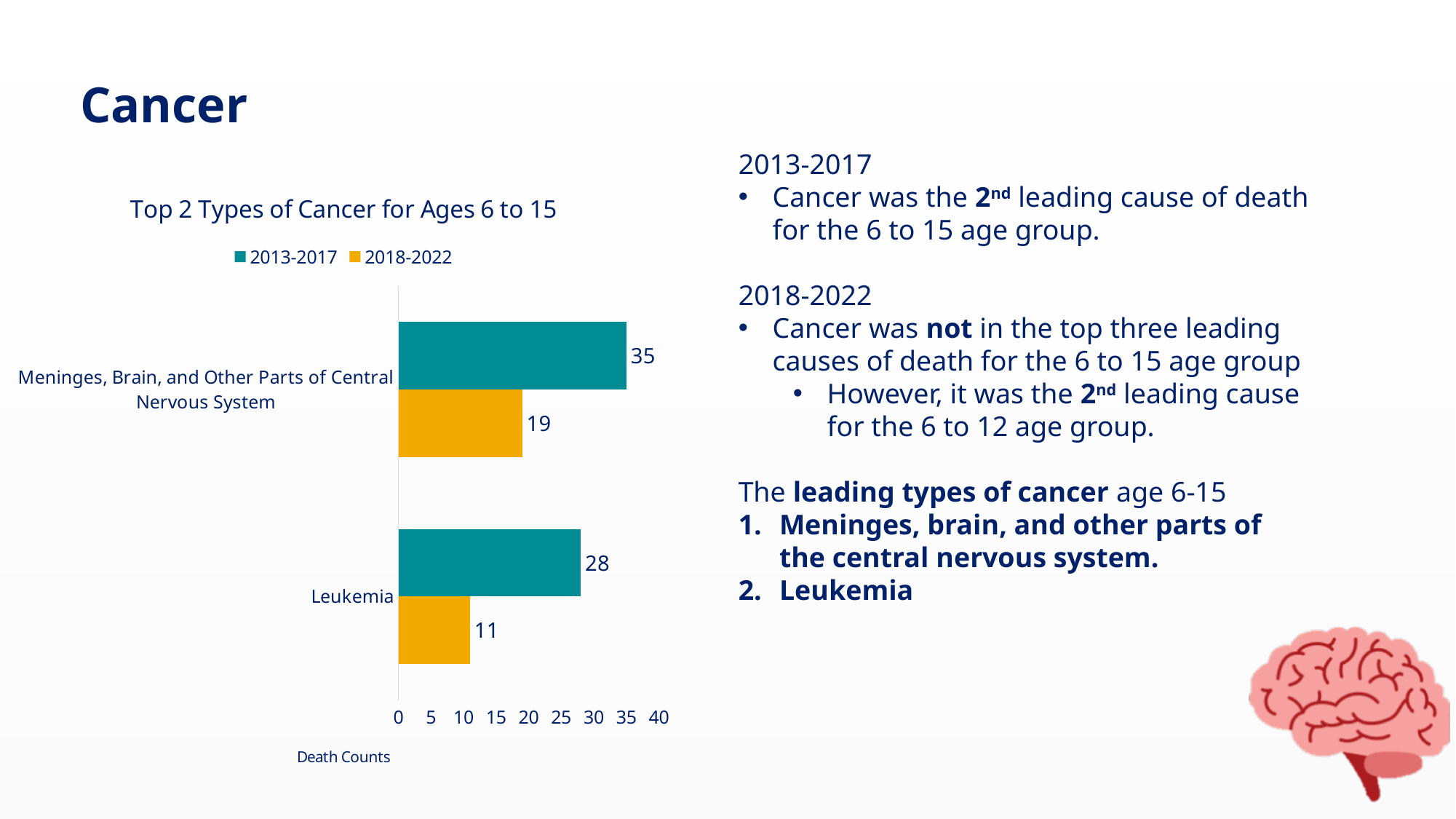
What is the death count for Leukemia in 2013-2017? 28 What is the difference between the 2013-2017 and 2018-2022 death counts for Leukemia? 17 Which is larger: the 2013-2017 death count for Leukemia or the 2018-2022 death count for Meninges, Brain, and Other Parts of Central Nervous System? 2013-2017 death count for Leukemia What is the title of the chart? Top 2 Types of Cancer for Ages 6 to 15 What kind of chart is shown on the slide? Bar chart Which category has the lowest death count in 2018-2022? Leukemia What is the death count for Meninges, Brain, and Other Parts of Central Nervous System in 2018-2022? 19 Which category has the highest death count in 2013-2017? Meninges, Brain, and Other Parts of Central Nervous System What is the difference between the 2013-2017 and 2018-2022 death counts for Meninges, Brain, and Other Parts of Central Nervous System? 16 What is the death count for Leukemia in 2018-2022? 11 How many series does the legend list? 2 How many cancer types are shown in the chart? 2